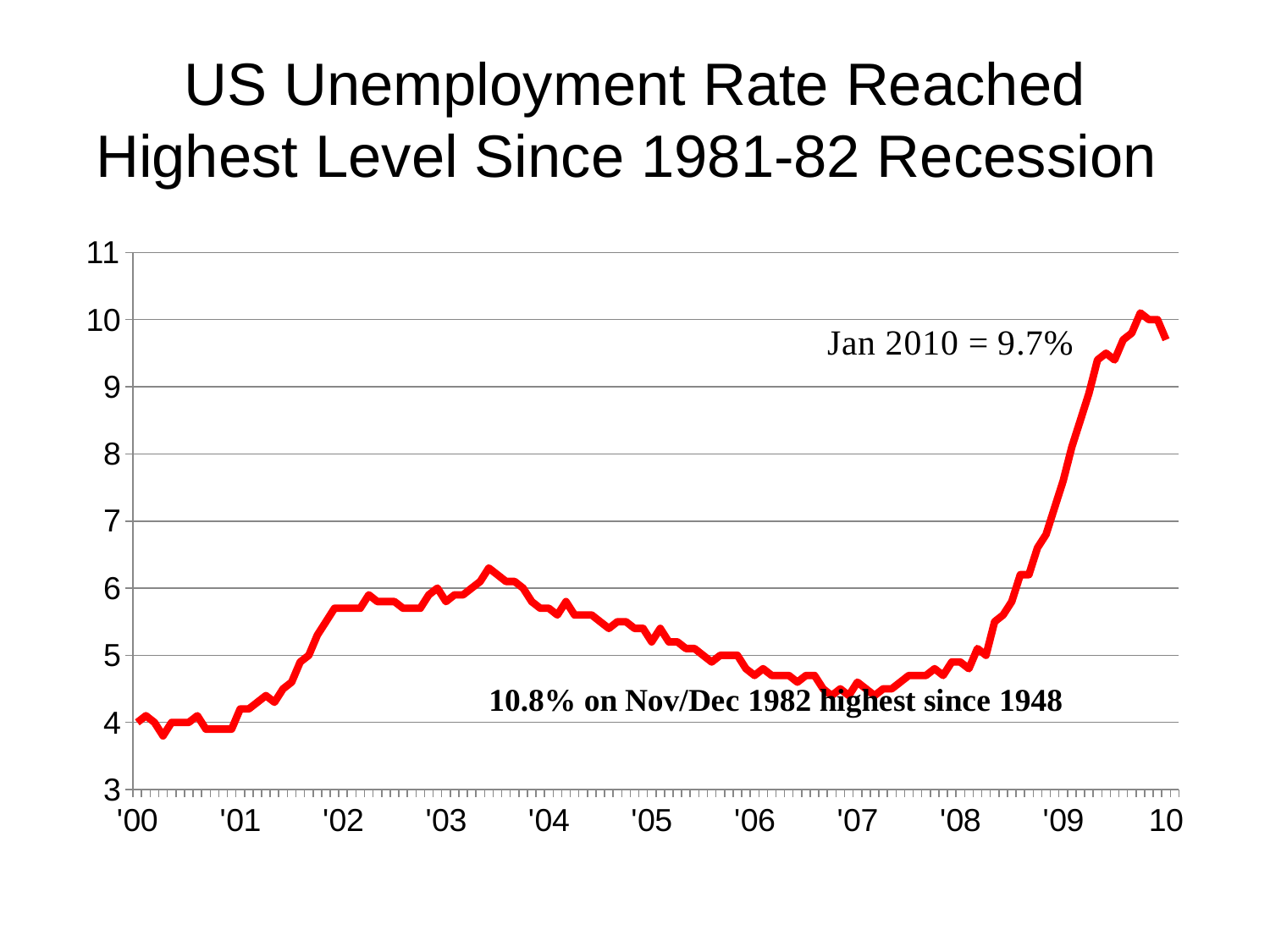
In which year labelled on the x axis does the line reach its highest point? '09 How many year labels are shown on the x axis? 11 Is the unemployment rate at the '09 tick greater or less than 7? greater What kind of chart is shown on the slide? line chart Is the unemployment rate at the '05 tick greater or less than 6? less Does the unemployment rate rise or fall between the '08 tick and the '09 tick? rise According to the annotation on the chart, what unemployment rate was reached in Nov/Dec 1982? 10.8% Is the unemployment rate higher at the '03 tick or at the '06 tick? '03 Is the unemployment rate at the '02 tick greater or less than 5? greater What is the title of the slide? US Unemployment Rate Reached Highest Level Since 1981-82 Recession According to the annotation on the chart, what was the US unemployment rate in Jan 2010? 9.7%